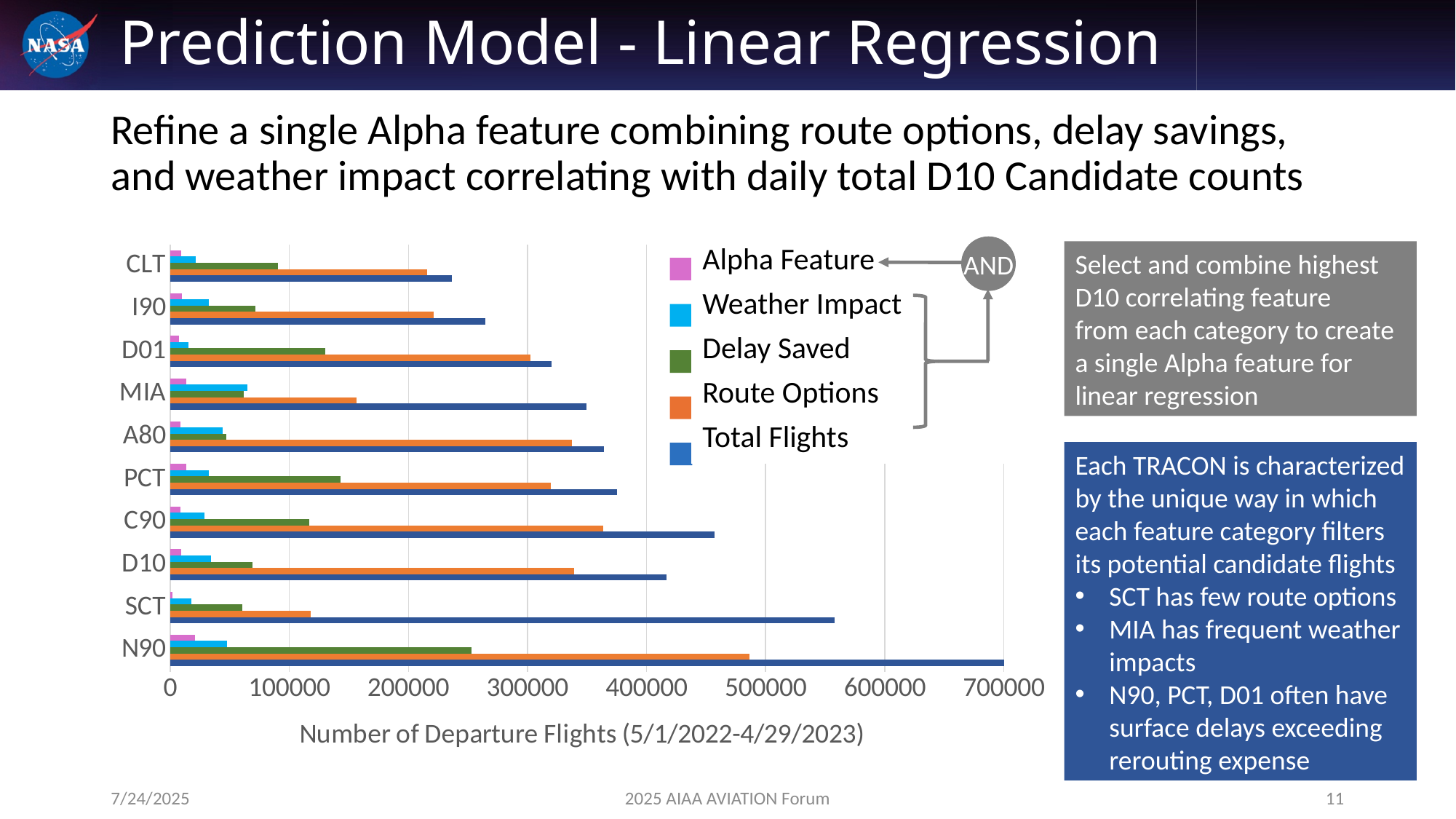
Which category has the highest Route Options value? N90 How many series does the chart legend list? 5 Which category has the lowest Total Flights value? CLT Which category has the lowest Route Options value? SCT Is the Route Options value for SCT greater or less than 200000? less Is the Route Options value for N90 greater or less than 400000? greater Is the Total Flights value for C90 greater or less than 400000? greater How many TRACON categories are shown on the y axis of the chart? 10 What kind of chart is shown on the slide? Bar chart What is the title of the chart's x axis? Number of Departure Flights (5/1/2022-4/29/2023) Which is larger, the Total Flights value for SCT or for D10? SCT Which category has the highest Total Flights value? N90